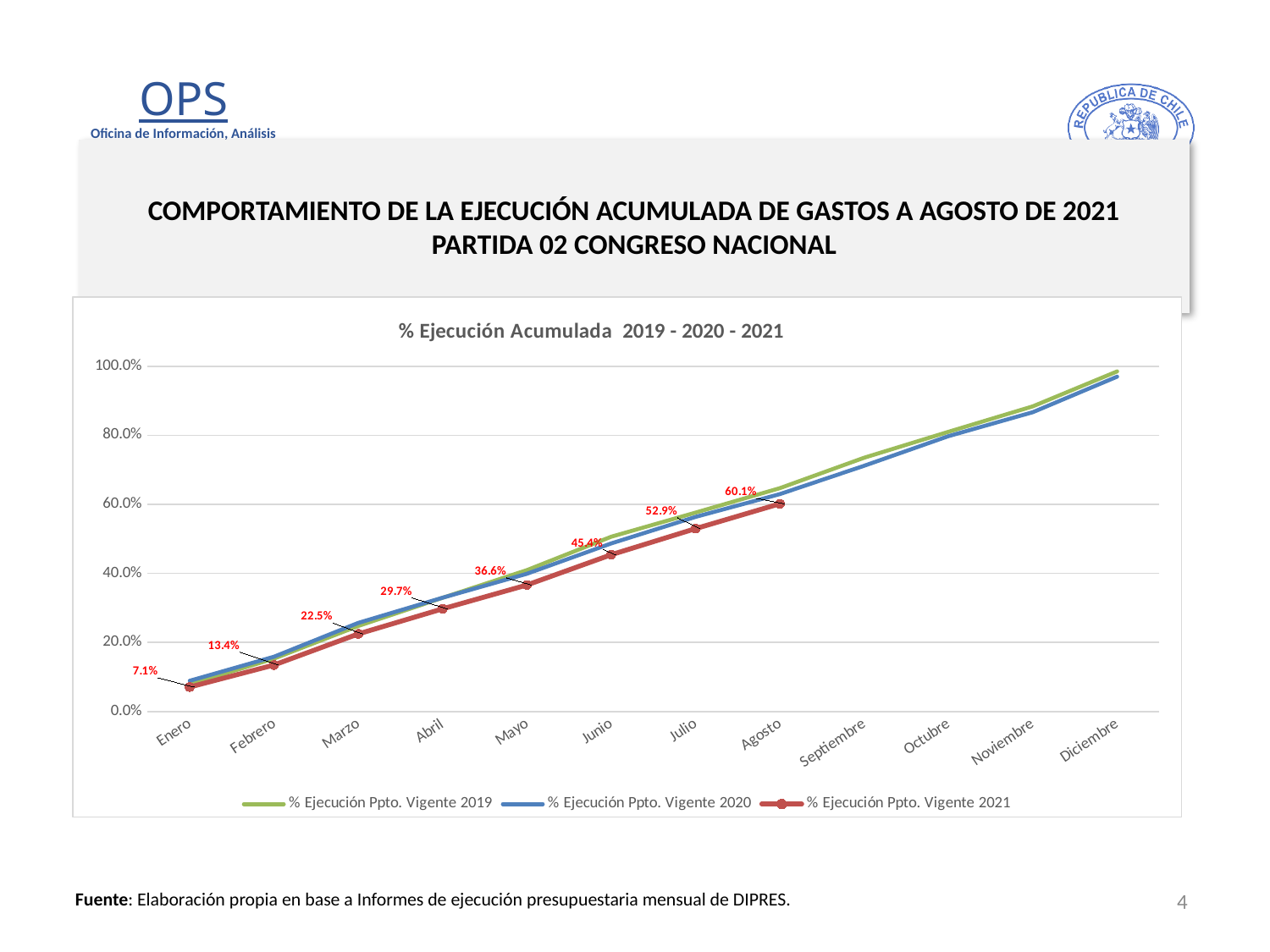
Which is larger in Marzo: the 2021 value or the 2020 value? 2020 What is the title of the chart? % Ejecución Acumulada 2019 - 2020 - 2021 Which month has the lowest value for % Ejecución Ppto. Vigente 2021? Enero What is the value for % Ejecución Ppto. Vigente 2021 in Enero? 7.1% What is the value for % Ejecución Ppto. Vigente 2021 in Agosto? 60.1% What is the value for % Ejecución Ppto. Vigente 2021 in Mayo? 36.6% How many months are shown on the x axis? 12 How many series does the legend list? 3 What kind of chart is shown on the slide? line chart Do the values for % Ejecución Ppto. Vigente 2021 rise or fall from Enero to Agosto? rise What is the difference between the 2021 values for Agosto and Julio? 7.2% Is the value for % Ejecución Ppto. Vigente 2019 in Diciembre greater or less than 80.0%? greater